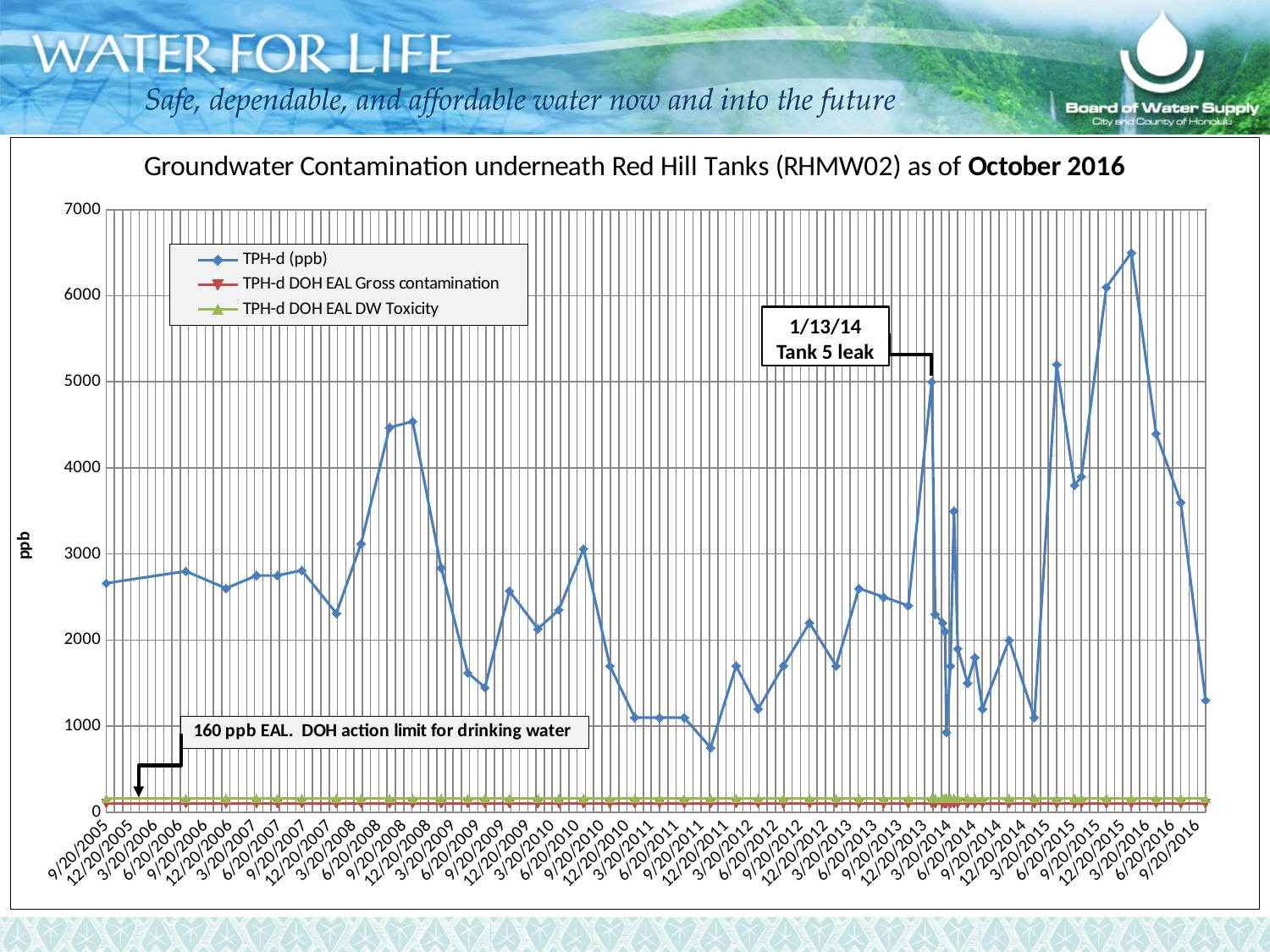
Is the TPH-d DOH EAL DW Toxicity line greater or less than 1000 ppb? less Is the highest TPH-d (ppb) value on the chart greater or less than 6000? greater Is the TPH-d (ppb) value at 9/20/2005 greater or less than 2000? greater What is the highest value shown on the y axis? 7000 What event does the annotation on the chart mark on 1/13/14? Tank 5 leak Which is larger, the TPH-d (ppb) value at 9/20/2005 or at 9/20/2016? 9/20/2005 How many series does the legend list? 3 What is the title of the chart? Groundwater Contamination underneath Red Hill Tanks (RHMW02) as of October 2016 Does the TPH-d (ppb) value rise or fall between 9/20/2008 and 9/20/2009? fall What kind of chart is shown on the slide? Line chart